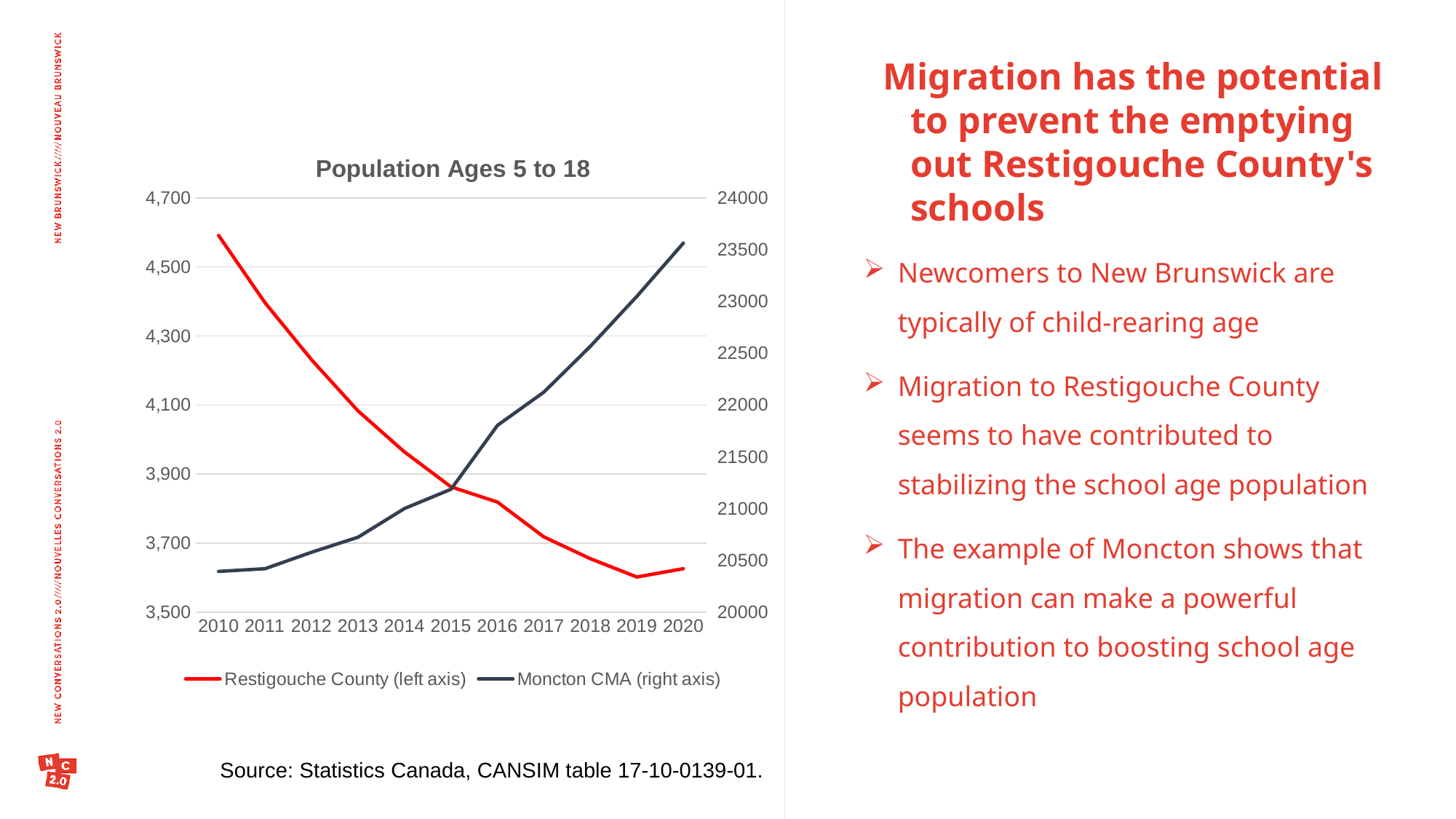
Is the Moncton CMA value for 2020 greater or less than 23000? greater How many series does the chart's legend list? 2 What kind of chart is shown on the slide? Line chart In which year is the Moncton CMA population ages 5 to 18 highest? 2020 Is the Restigouche County value for 2010 greater or less than 4,500? greater Does the Restigouche County line rise or fall from 2010 to 2020? Fall In which year is the Restigouche County population ages 5 to 18 highest? 2010 Does the Moncton CMA line rise or fall from 2010 to 2020? Rise How many years are plotted along the x axis of the chart? 11 In which year is the Moncton CMA population ages 5 to 18 lowest? 2010 What is the title of the chart? Population Ages 5 to 18 Which series is plotted against the right axis? Moncton CMA